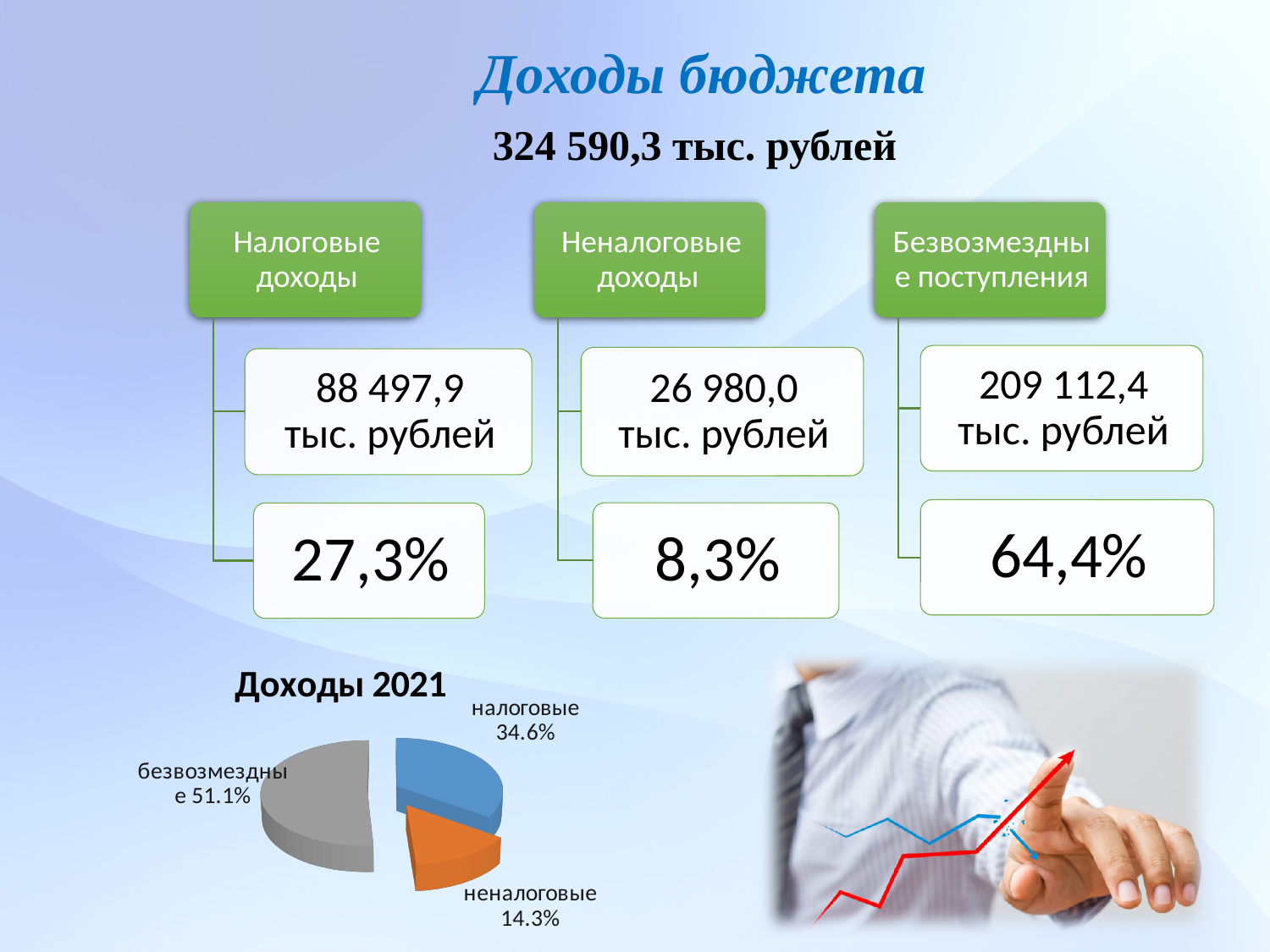
What kind of chart is shown under the title "Доходы 2021"? pie chart Which slice of the "Доходы 2021" pie chart is the largest? безвозмездные In the "Доходы 2021" pie chart, which is larger: налоговые or неналоговые? налоговые In the "Доходы 2021" pie chart, what is the difference in percentage points between налоговые and неналоговые? 20.3 In the "Доходы 2021" pie chart, what share is shown for неналоговые? 14.3% Which slice of the "Доходы 2021" pie chart is the smallest? неналоговые In the "Доходы 2021" pie chart, what share is shown for налоговые? 34.6% What colour is the безвозмездные slice in the "Доходы 2021" pie chart? grey How many slices does the "Доходы 2021" pie chart have? 3 In the "Доходы 2021" pie chart, what is the difference in percentage points between безвозмездные and налоговые? 16.5 In the "Доходы 2021" pie chart, what share is shown for безвозмездные? 51.1% What is the title of the pie chart on the slide? Доходы 2021